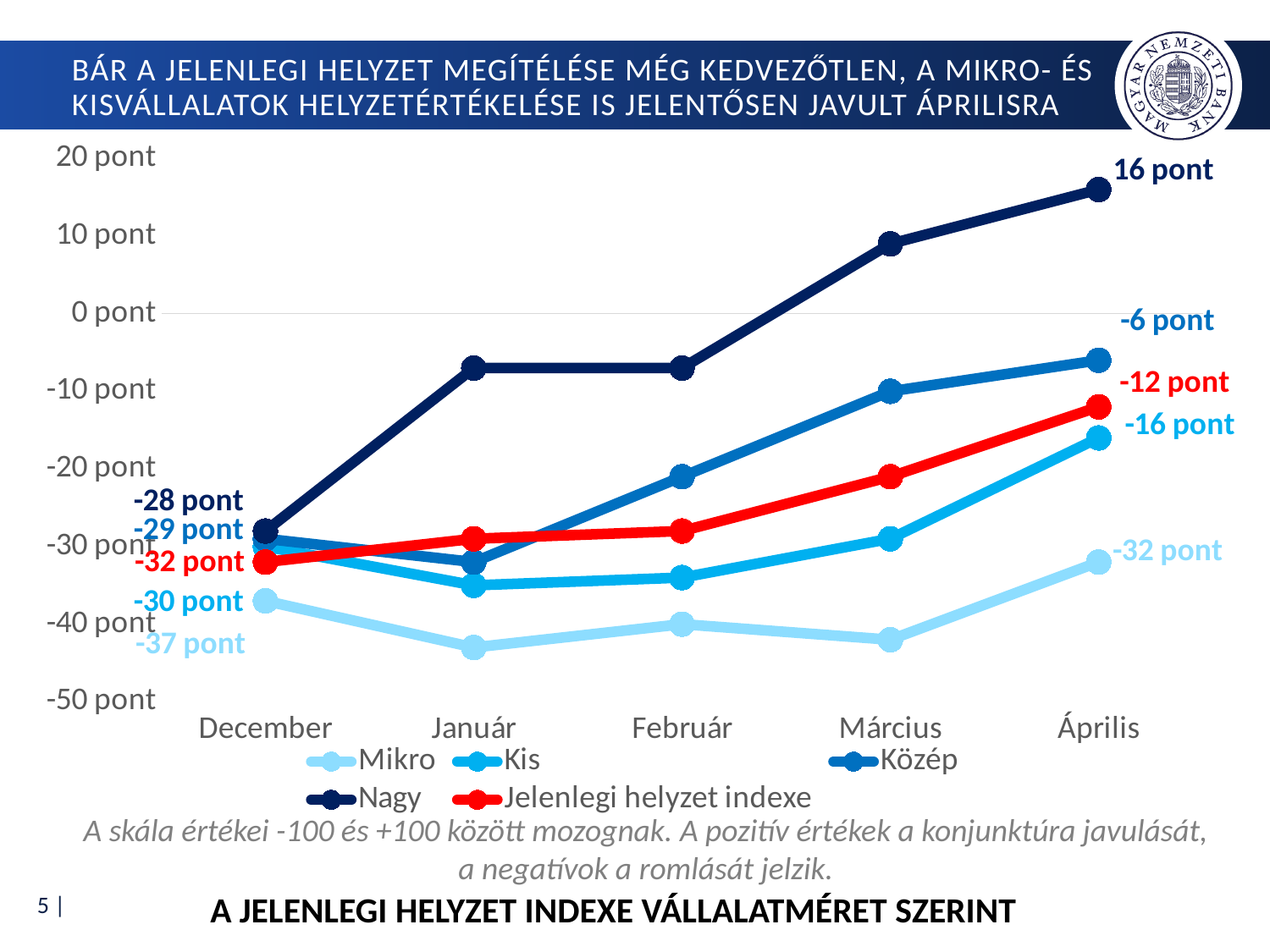
Is the value of the Nagy series in Március greater or less than 0 pont? greater Which series has the highest value in Április? Nagy How many months are shown on the x axis? 5 Which series has the lowest value in December? Mikro Does the Kis series rise or fall from Február to Április? rise How many series does the legend list? 5 What is the value of the Közép series in Április? -6 pont What is the value of the Mikro series in December? -37 pont What is the value of the Nagy series in Április? 16 pont What is the value of the Jelenlegi helyzet indexe series in Április? -12 pont What type of chart is shown on the slide? line chart By how much did the Nagy series change from December (-28 pont) to Április (16 pont)? 44 pont